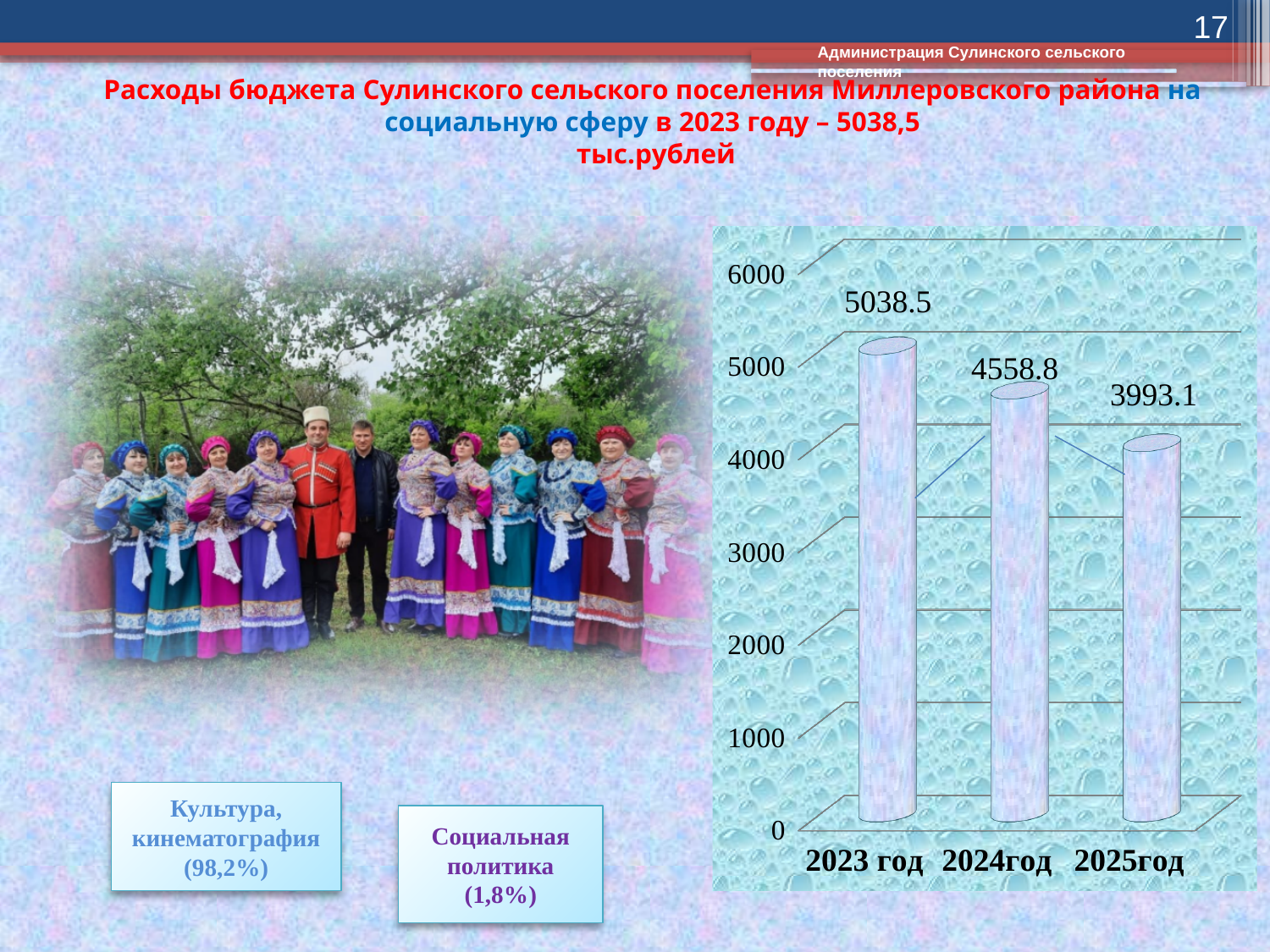
Which is larger, the value for 2023 год or the value for 2025год? 2023 год Is the value for 2025год greater or less than 4000? less What is the value for 2025год? 3993.1 What kind of chart is shown on the slide? bar chart Do the values rise or fall from 2023 год to 2025год? fall Which year has the highest value? 2023 год Which year has the lowest value? 2025год What is the difference between the values for 2024год and 2025год? 565.7 What is the value for 2023 год? 5038.5 What is the difference between the values for 2023 год and 2024год? 479.7 How many categories are shown on the x axis? 3 What is the value for 2024год? 4558.8